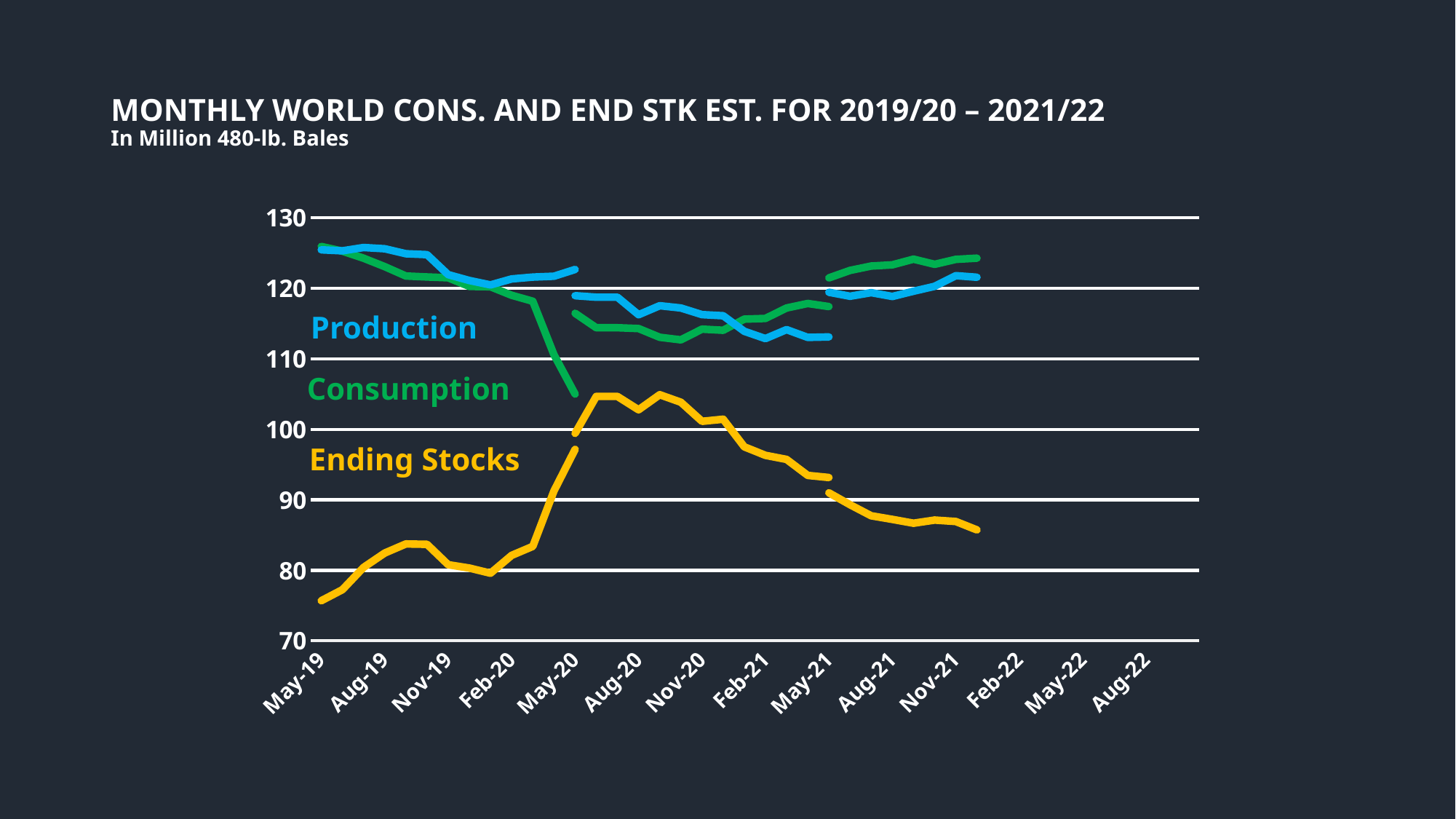
Is the value for Ending Stocks at Aug-20 greater or less than 100? greater What kind of chart is shown on the slide? Line chart How many series are labelled on the chart? 3 Is the value for Ending Stocks at Nov-21 greater or less than 90? less At May-19, which is larger: Production or Ending Stocks? Production Is the value for Production at May-21 greater or less than 110? greater Do the Consumption values rise or fall from May-19 to May-20? Fall What unit is the chart measured in, according to the subtitle? In Million 480-lb. Bales Do the Ending Stocks values rise or fall from Aug-20 to May-21? Fall Which series is drawn in yellow? Ending Stocks